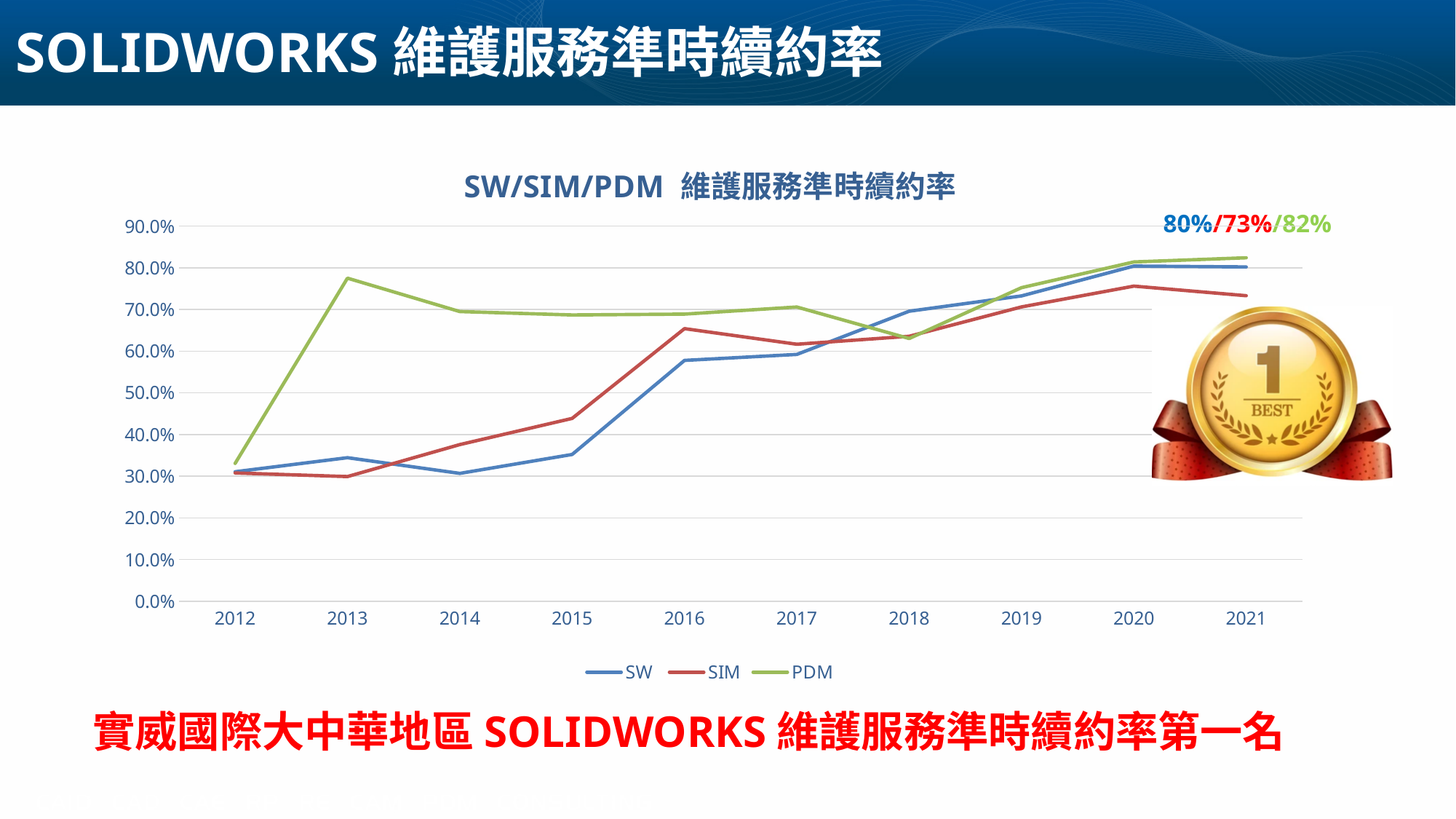
What is the value for SW in 2021? 80% What is the value for PDM in 2021? 82% What is the difference between the PDM and SIM values in 2021? 9% Which series has the highest value in 2021? PDM In 2021, which is larger, the value for SW or the value for SIM? SW Is the value for PDM in 2013 greater or less than 70.0%? greater What kind of chart is shown on the slide? line chart How many series does the legend list? 3 Is the value for SW in 2012 greater or less than 40.0%? less Does the SW series generally rise or fall from 2012 to 2021? rise How many years are shown along the x axis? 10 What is the value for SIM in 2021? 73%